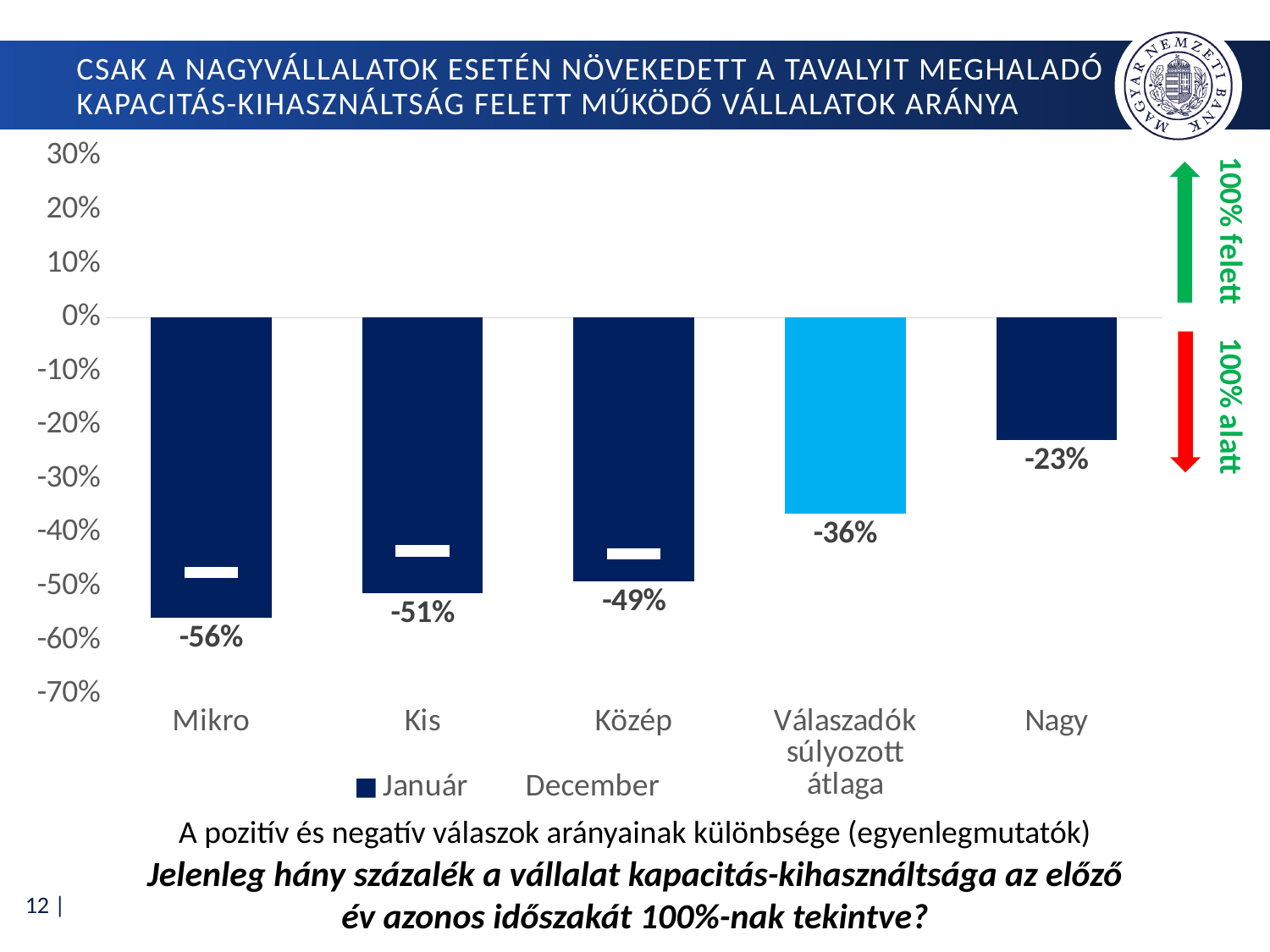
What kind of chart is shown on the slide? Bar chart Is the December value for Kis greater or less than -50%? greater What is the Január value for Nagy? -23% Which category has the highest Január value? Nagy How many series does the legend list? 2 Which category has the lowest Január value? Mikro How many categories are shown on the x axis? 5 What is the Január value for Közép? -49% What is the Január value for Válaszadók súlyozott átlaga? -36% What is the Január value for Mikro? -56% Which has a higher Január value, Kis or Közép? Közép What is the difference between the Január values for Nagy and Mikro? 33 percentage points